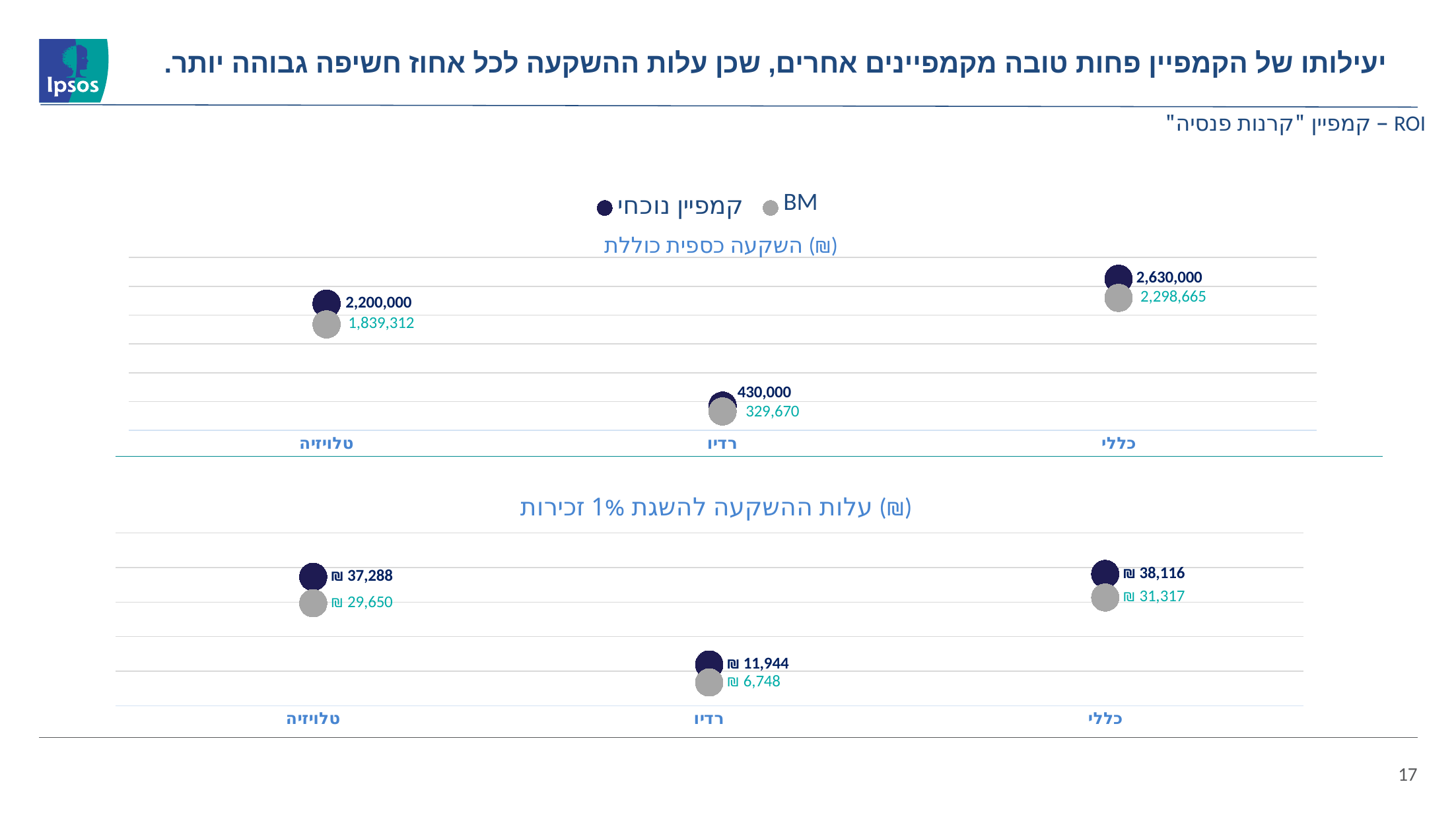
In the bottom chart (עלות ההשקעה להשגת 1% זכירות), which category has the highest קמפיין נוכחי value? כללי In the bottom chart (עלות ההשקעה להשגת 1% זכירות), what is the BM value for כללי? ₪ 31,317 In the top chart (השקעה כספית כוללת), what is the difference between the קמפיין נוכחי and BM values for רדיו? 100,330 How many series does the legend list? 2 How many categories are shown on the x axis of the top chart (השקעה כספית כוללת)? 3 In the top chart (השקעה כספית כוללת), what is the BM value for רדיו? 329,670 In the top chart (השקעה כספית כוללת), which category has the lowest קמפיין נוכחי value? רדיו In the bottom chart (עלות ההשקעה להשגת 1% זכירות), what is the קמפיין נוכחי value for רדיו? ₪ 11,944 In the top chart (השקעה כספית כוללת), what is the BM value for טלוויזיה? 1,839,312 In the bottom chart (עלות ההשקעה להשגת 1% זכירות), what is the difference between the קמפיין נוכחי and BM values for טלוויזיה? ₪ 7,638 In the bottom chart (עלות ההשקעה להשגת 1% זכירות), which is larger for רדיו: the קמפיין נוכחי value or the BM value? קמפיין נוכחי In the top chart (השקעה כספית כוללת), what is the value of קמפיין נוכחי for כללי? 2,630,000